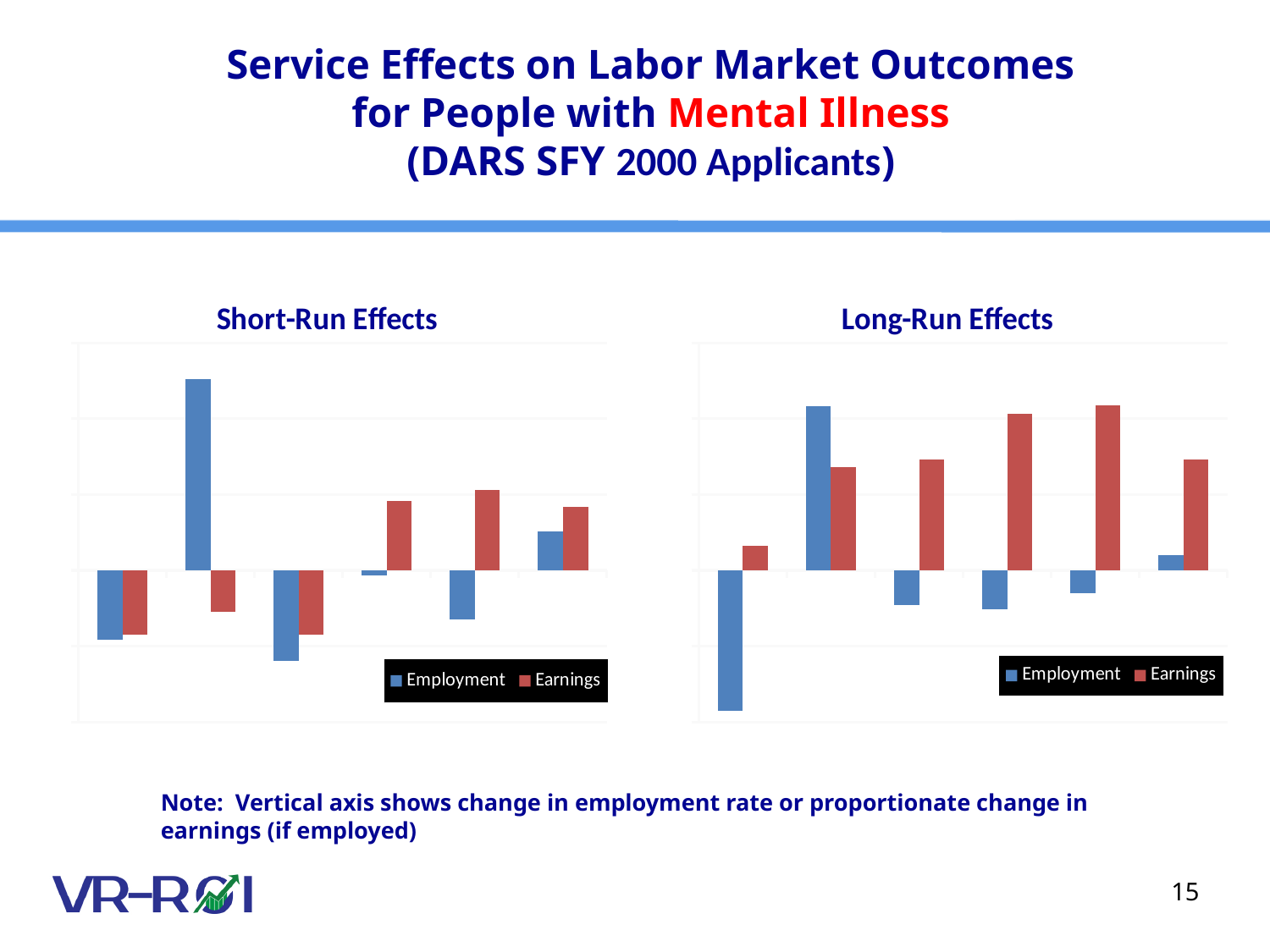
In the Long-Run Effects chart, how many groups of bars are plotted? 6 How many series does the legend of the Long-Run Effects chart list? 2 How many series does the legend of the Short-Run Effects chart list? 2 In the Short-Run Effects chart, how many groups of bars are plotted? 6 What are the two series named in the legend of the Long-Run Effects chart? Employment and Earnings In the Long-Run Effects chart, how many Earnings bars are negative? 0 What kind of chart is the Long-Run Effects chart? bar chart In the Short-Run Effects chart, which series does the tallest bar belong to? Employment What kind of chart is the Short-Run Effects chart? bar chart In the Long-Run Effects chart, which series does the lowest (most negative) bar belong to? Employment What colour represents the Earnings series in the Short-Run Effects chart? red